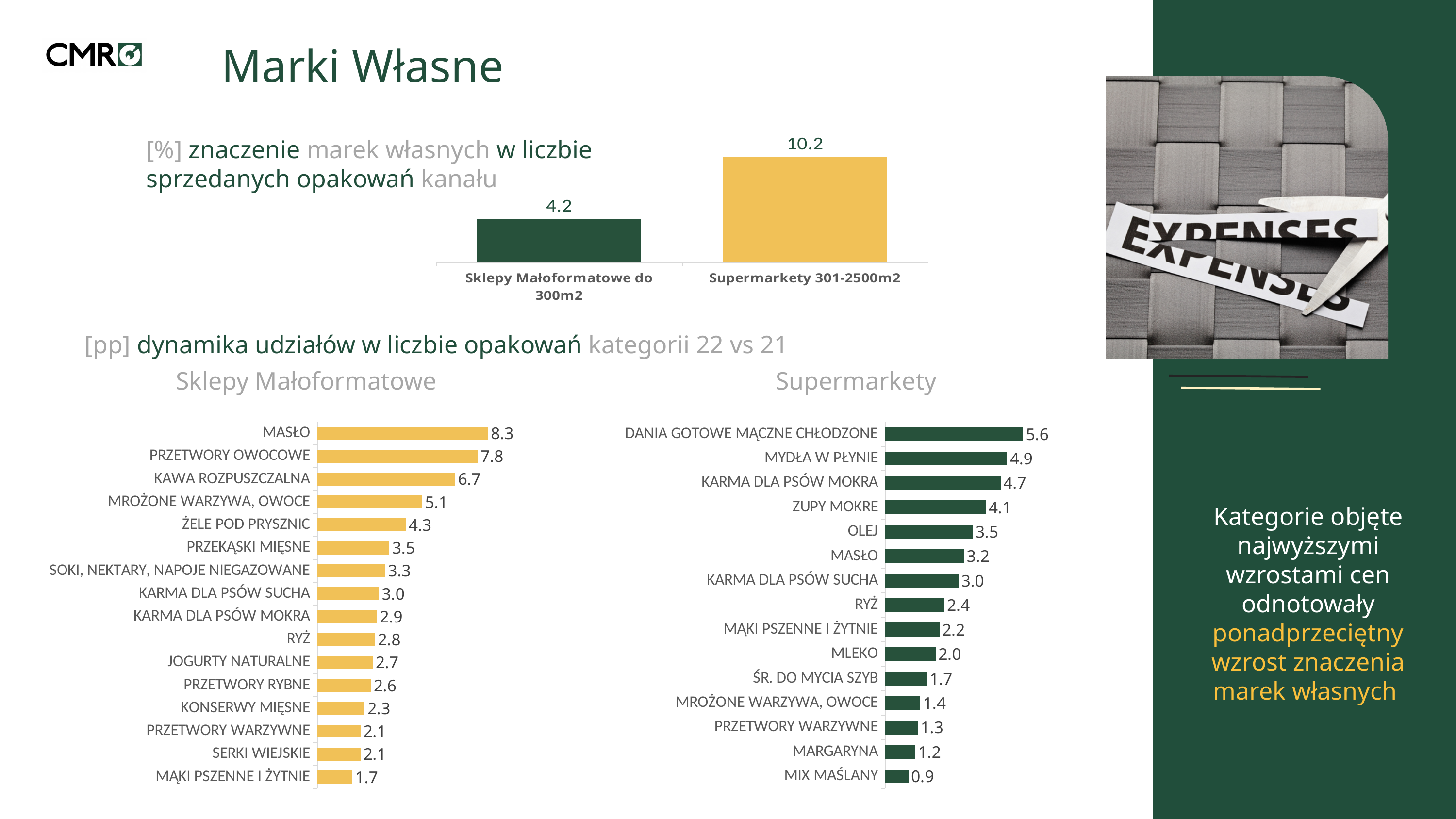
In the Supermarkety chart, what is the value for ZUPY MOKRE? 4.1 Which is larger: MASŁO in the Sklepy Małoformatowe chart or MASŁO in the Supermarkety chart? MASŁO in the Sklepy Małoformatowe chart In the top chart, what is the difference between the Supermarkety 301-2500m2 value and the Sklepy Małoformatowe do 300m2 value? 6.0 In the top chart, what is the value for Sklepy Małoformatowe do 300m2? 4.2 In the top chart, what is the value for Supermarkety 301-2500m2? 10.2 In the Sklepy Małoformatowe chart, what is the value for KAWA ROZPUSZCZALNA? 6.7 How many categories are shown in the Supermarkety chart? 15 In the Sklepy Małoformatowe chart, which category has the lowest value? MĄKI PSZENNE I ŻYTNIE How many categories are shown in the Sklepy Małoformatowe chart? 16 In the Supermarkety chart, which category has the highest value? DANIA GOTOWE MĄCZNE CHŁODZONE In the Sklepy Małoformatowe chart, which category has the highest value? MASŁO In the Supermarkety chart, what is the difference between MYDŁA W PŁYNIE and MIX MAŚLANY? 4.0